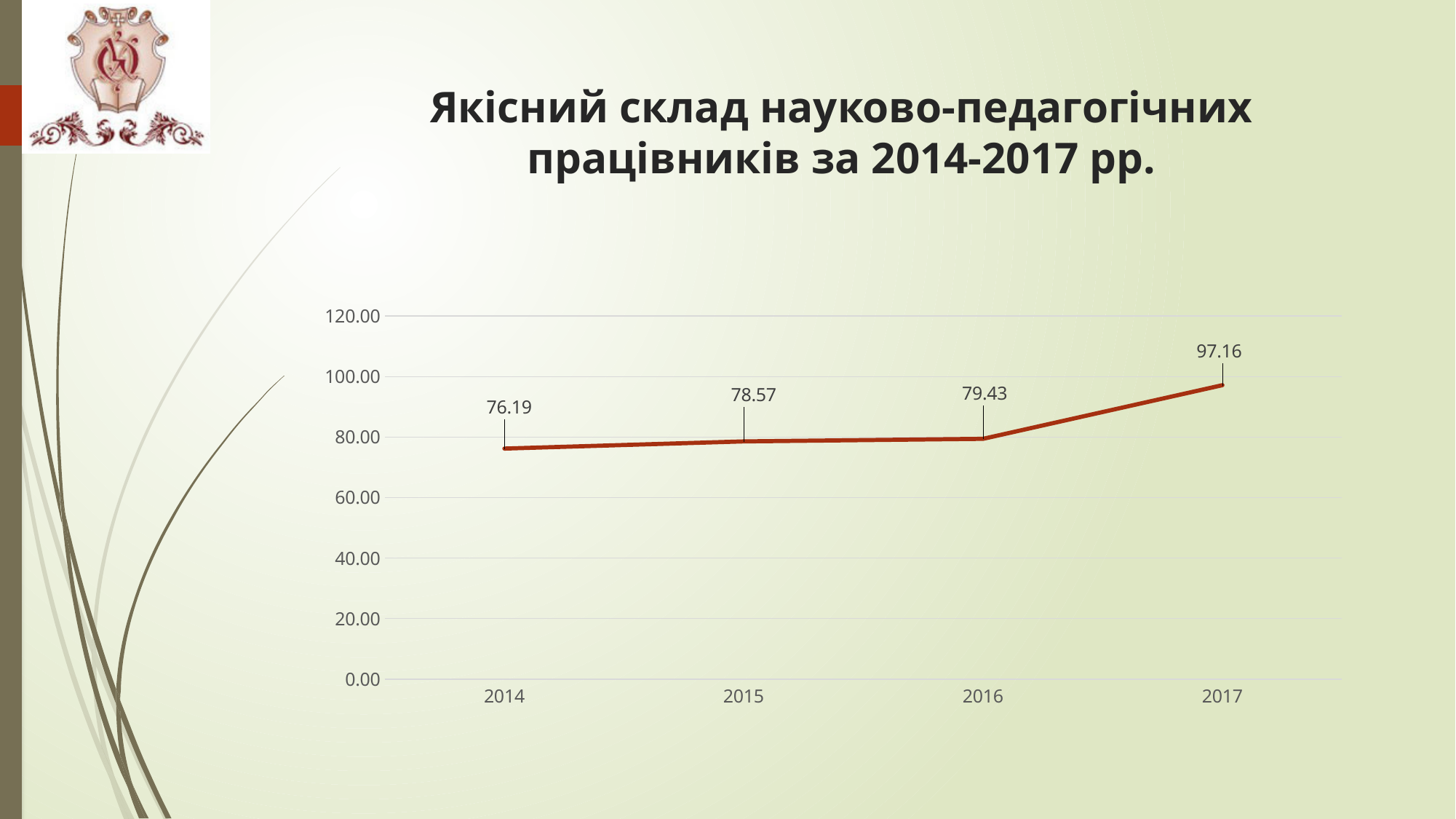
What is the value for 2015? 78.57 What is the value for 2014? 76.19 What kind of chart is shown on the slide? line chart What is the difference between the values for 2017 and 2016? 17.73 How many years are plotted on the chart? 4 Which is larger, the value for 2017 or the value for 2014? 2017 Which year has the highest value? 2017 What is the difference between the values for 2015 and 2014? 2.38 Is the value for 2017 greater or less than 100? less What is the value for 2017? 97.16 Which year has the lowest value? 2014 What is the value for 2016? 79.43